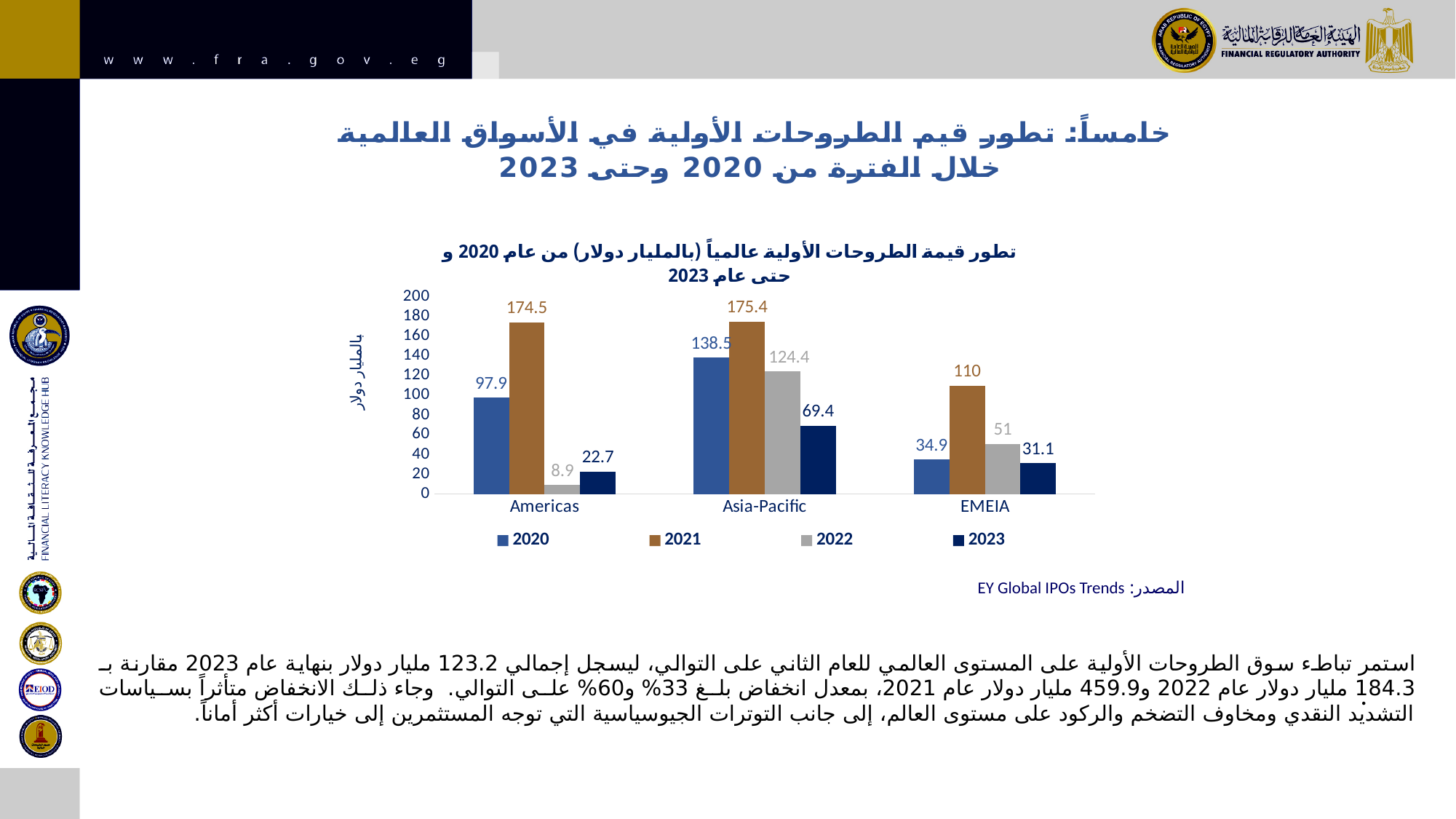
What is the value for EMEIA in 2023? 31.1 Which is larger for EMEIA: the 2020 value or the 2022 value? 2022 What is the value for Americas in 2022? 8.9 Which region has the lowest value in 2022? Americas What is the source cited below the chart? EY Global IPOs Trends What is the value for Asia-Pacific in 2021? 175.4 What kind of chart is shown on the slide? Bar chart Which region has the highest value in 2020? Asia-Pacific How many series does the legend list? 4 How many regions are shown on the x axis? 3 For Americas, do the values rise or fall from 2021 to 2022? Fall What is the difference between the 2021 and 2023 values for Asia-Pacific? 106